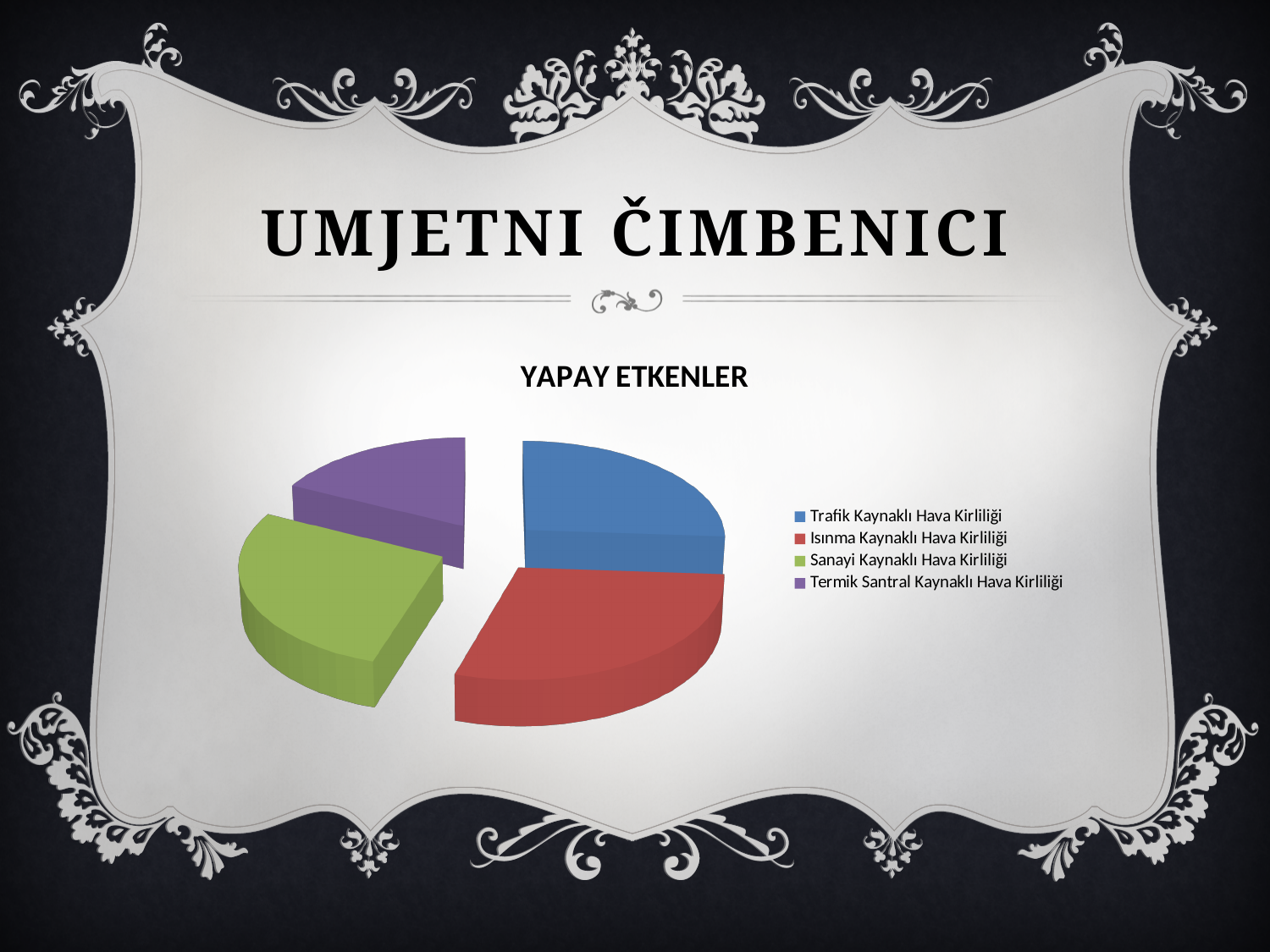
Which slice is larger: Isınma Kaynaklı Hava Kirliliği or Termik Santral Kaynaklı Hava Kirliliği? Isınma Kaynaklı Hava Kirliliği What kind of chart is shown on the slide? Pie chart Which slice is larger: Trafik Kaynaklı Hava Kirliliği or Termik Santral Kaynaklı Hava Kirliliği? Trafik Kaynaklı Hava Kirliliği How many slices does the pie chart have? 4 How many entries does the legend list? 4 What is the title of the chart? YAPAY ETKENLER Which colour represents Sanayi Kaynaklı Hava Kirliliği in the pie chart? Green Which category has the smallest slice of the pie? Termik Santral Kaynaklı Hava Kirliliği